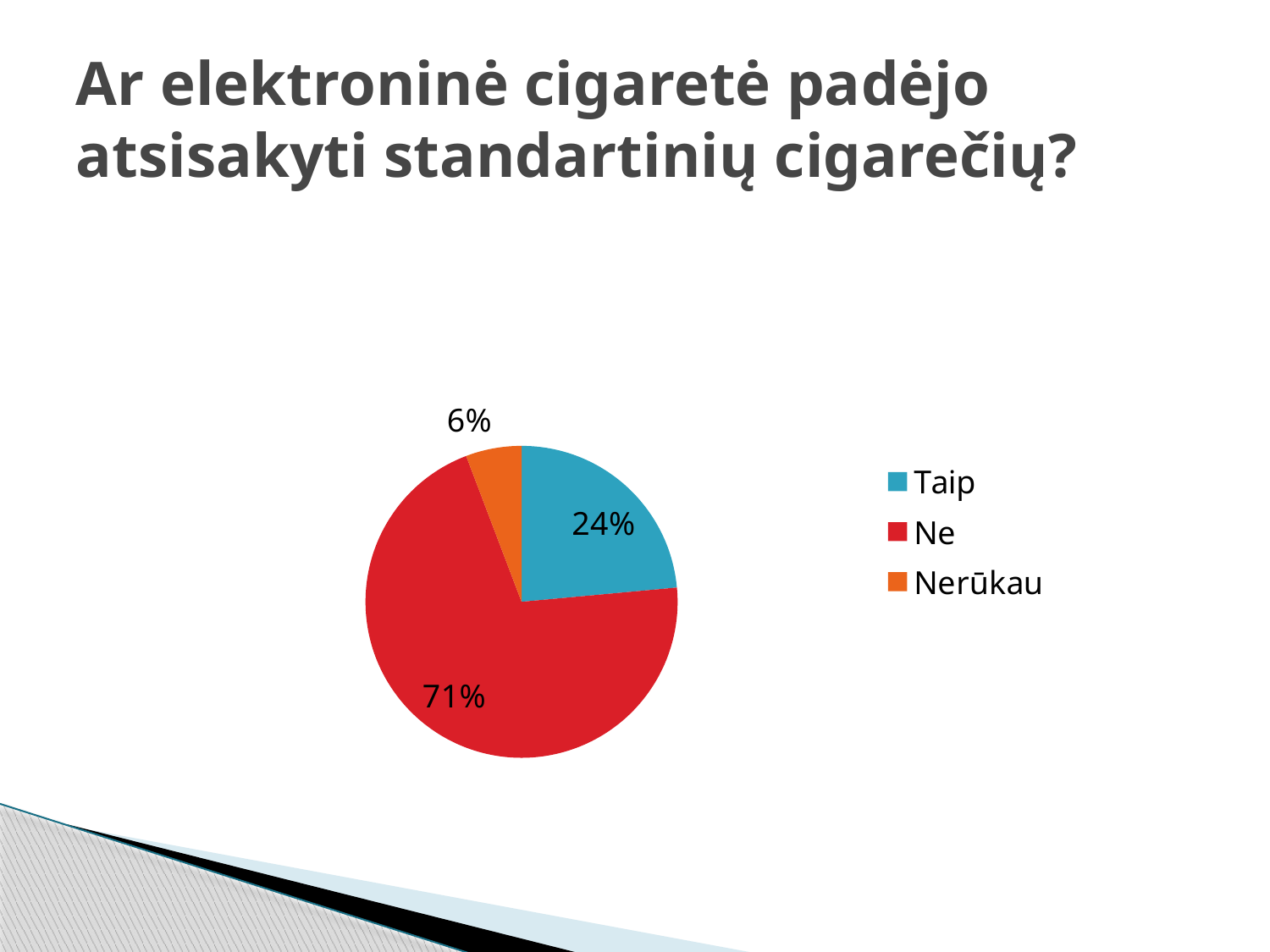
What is the difference in percentage points between the "Taip" and "Nerūkau" slices? 18 What share of the pie does "Nerūkau" represent? 6% What is the difference in percentage points between the "Ne" and "Taip" slices? 47 What colour is the "Ne" slice? red Which is larger, the "Taip" slice or the "Nerūkau" slice? Taip What share of the pie does "Ne" represent? 71% What kind of chart is shown on the slide? pie chart Which category has the largest slice of the pie? Ne What share of the pie does "Taip" represent? 24% Which category has the smallest slice of the pie? Nerūkau Which legend entry is shown in orange? Nerūkau How many categories does the pie chart have? 3